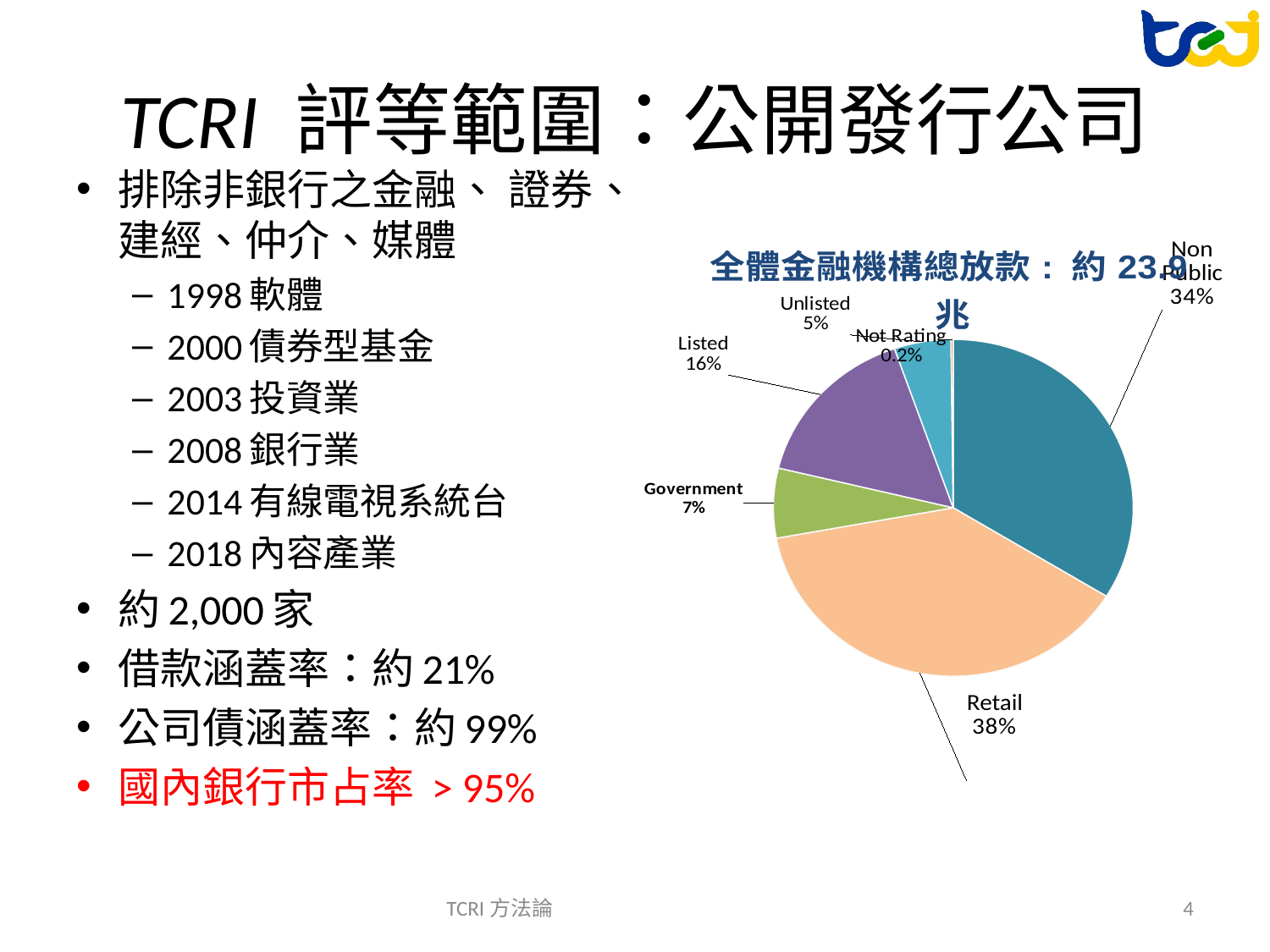
Which slice of the pie is the largest? Retail What is the value shown for Not Rating? 0.2% What is the value shown for Listed? 16% What share of the pie does Non Public have? 34% What is the value shown for Unlisted? 5% What is the difference between the Retail and Non Public shares? 4% How many slices does the pie chart have? 6 Which slice of the pie is the smallest? Not Rating Which is larger, Listed or Government? Listed What is the value shown for Government? 7% What kind of chart is shown on the slide? pie chart What share of the pie does Retail have? 38%